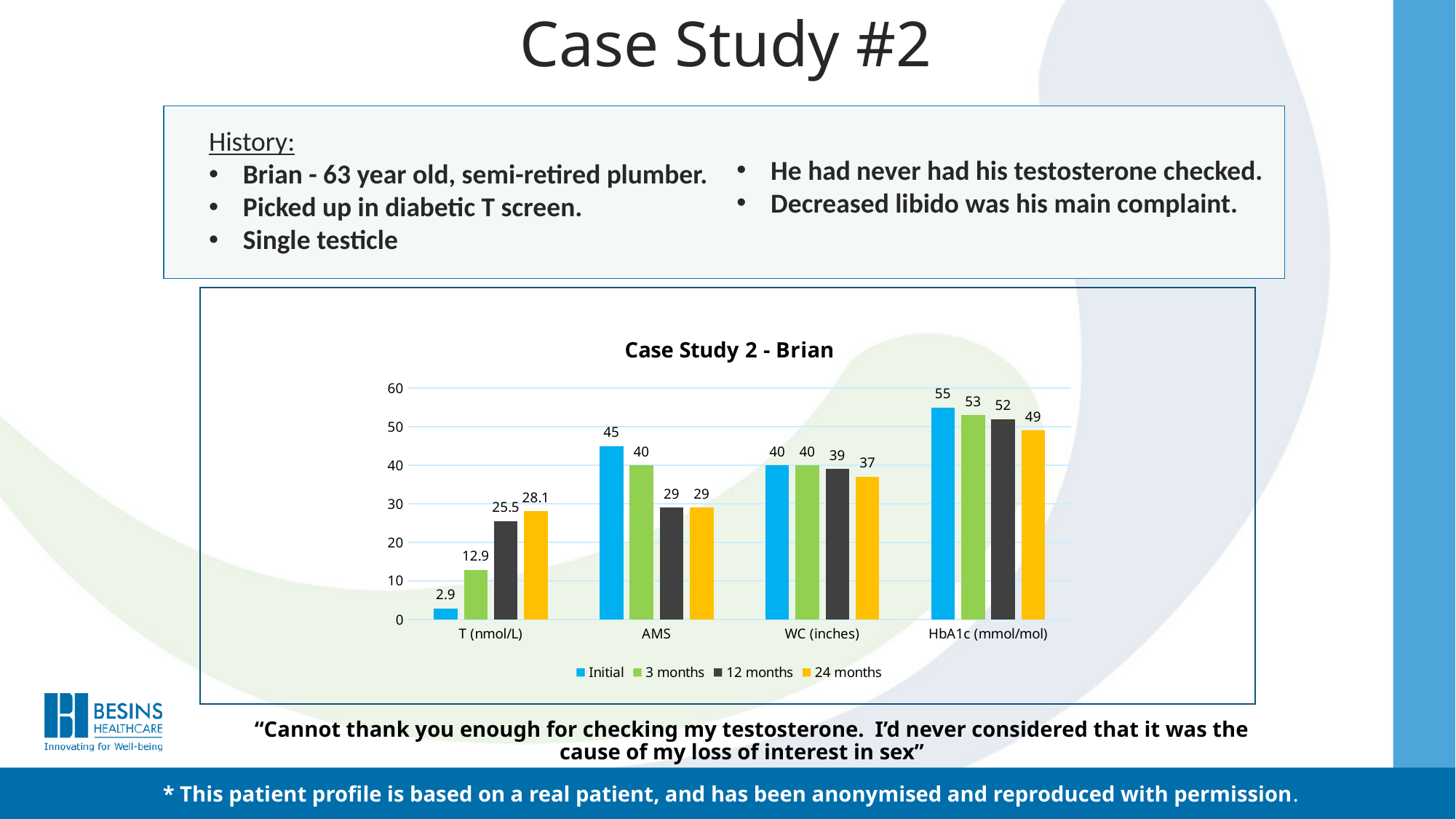
How many categories are shown on the x axis? 4 What is the Initial value for T (nmol/L)? 2.9 What is the 3 months value for WC (inches)? 40 What kind of chart is shown on the slide? Bar chart Which is larger for WC (inches): the 12 months value or the 24 months value? 12 months What is the 24 months value for HbA1c (mmol/mol)? 49 What is the 12 months value for AMS? 29 Which series has the lowest value for T (nmol/L)? Initial What is the difference between the Initial and 24 months values for AMS? 16 Which series has the highest value for HbA1c (mmol/mol)? Initial How many series does the legend list? 4 What is the difference between the 24 months and 12 months values for T (nmol/L)? 2.6